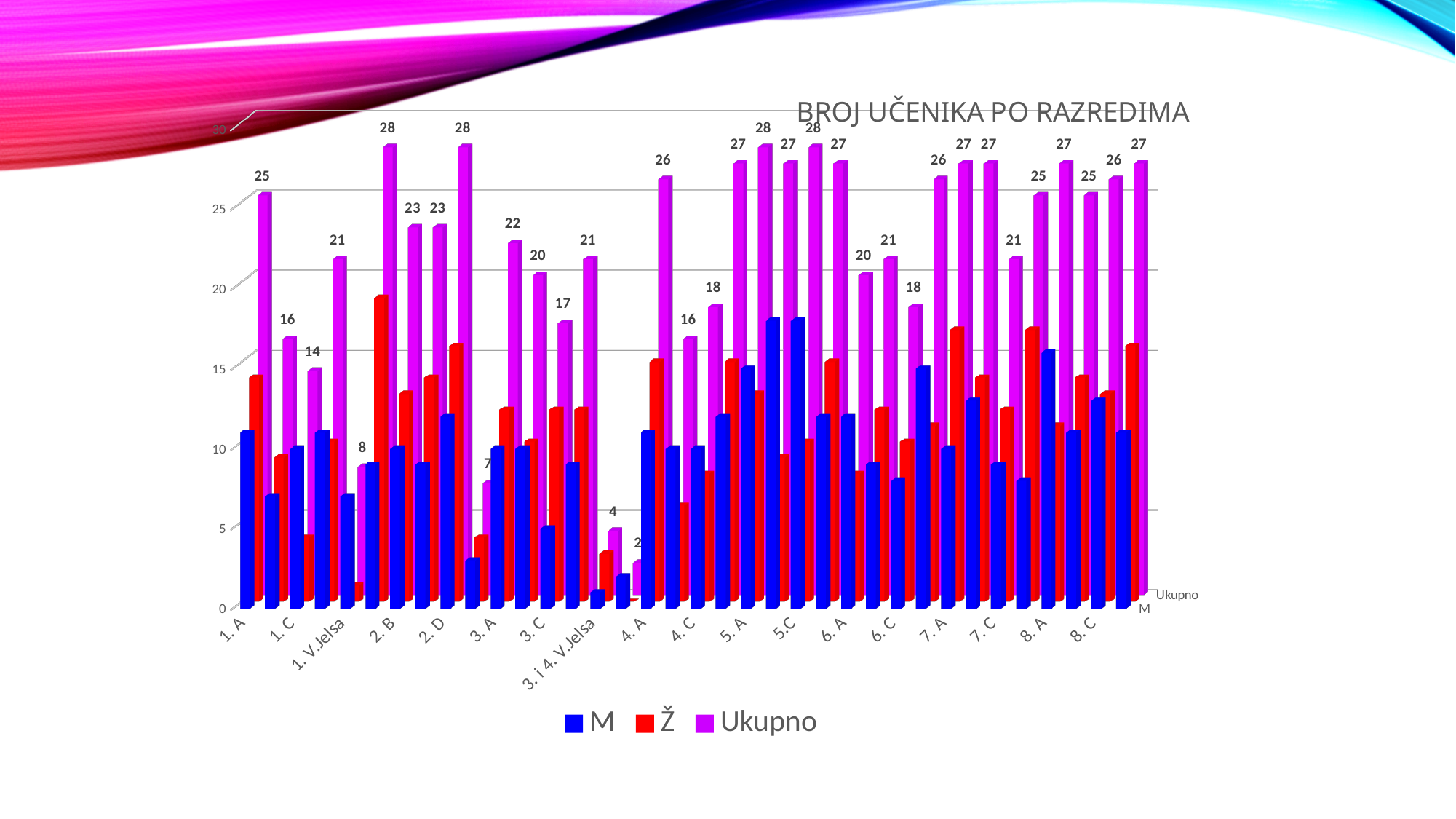
What kind of chart is shown on the slide? bar chart What is the Ukupno value for 1. A? 25 Is the Ž value for 1. V.Jelsa greater or less than 5? less How many series does the legend list? 3 What is the Ukupno value for 1. V.Jelsa? 8 What is the difference between the Ukupno values for 1. A and 1. V.Jelsa? 17 What is the title of the chart? BROJ UČENIKA PO RAZREDIMA Which has a larger Ukupno value, 5. A or 6. A? 5. A What is the Ukupno value for 3. i 4. V.Jelsa? 4 What is the Ukupno value for 4. A? 26 What is the lowest Ukupno value shown in the chart? 2 Which series are listed in the legend? M, Ž, Ukupno